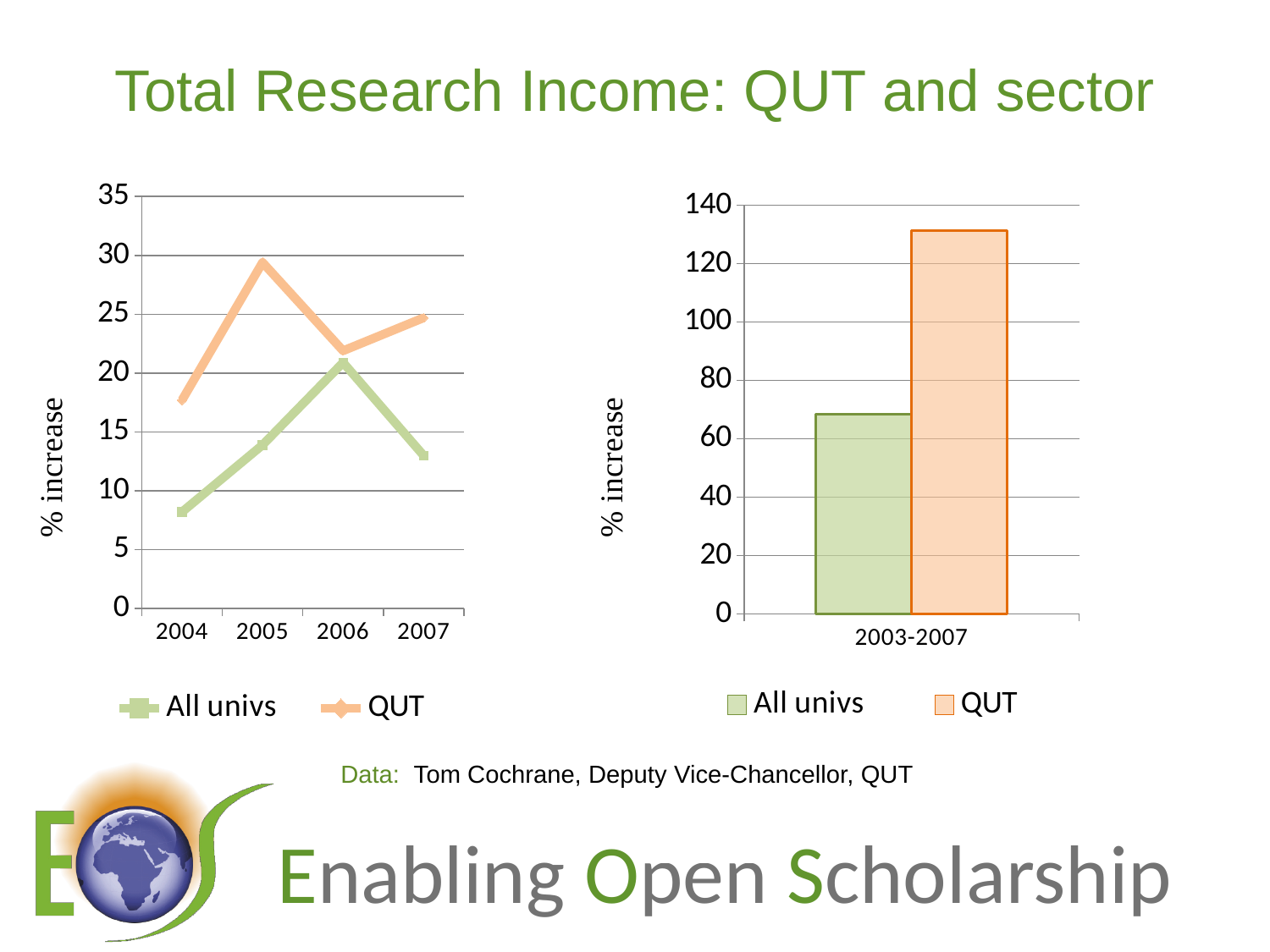
In the left chart, in which year is the All univs value lowest? 2004 In the left chart, is the QUT value for 2005 greater or less than 25? greater In the right chart, is the QUT value greater or less than 120? greater In the left chart, in which year is the All univs value highest? 2006 In the left chart, in which year is the QUT value highest? 2005 In the left chart, is the All univs value for 2004 greater or less than 10? less In the left chart, how many series does the legend list? 2 What kind of chart is the chart on the right of the slide? bar chart In the right chart, which is larger for 2003-2007, All univs or QUT? QUT In the left chart, how many years are shown on the x axis? 4 What kind of chart is the chart on the left of the slide? line chart